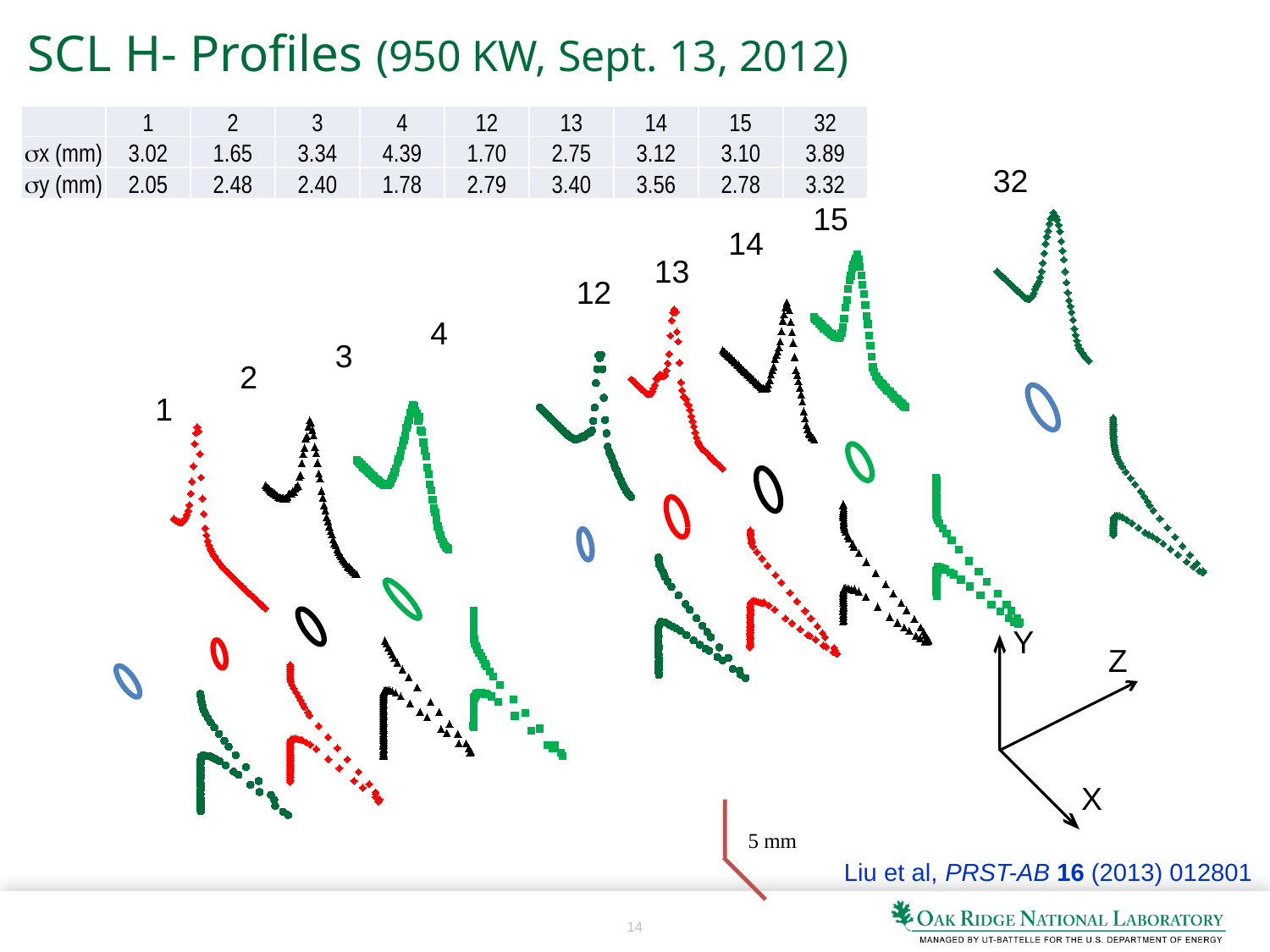
How many profile numbers are listed in the table? 9 What is the difference between the σx values of profile 4 and profile 2? 2.74 What length does the scale bar at the bottom of the profile plot represent? 5 mm What is the σx value for profile 32 in the table? 3.89 Which profile number has the smallest σx value in the table? 2 Which profile number has the largest σy value in the table? 14 What is the σx value for profile 4 in the table? 4.39 Which profile number has the largest σx value in the table? 4 What kind of chart is used to show the H- profiles on the slide? scatter plot Which profile number has the smallest σy value in the table? 4 What is the σy value for profile 13 in the table? 3.40 Which is larger, the σy value for profile 12 or the σy value for profile 15? profile 12